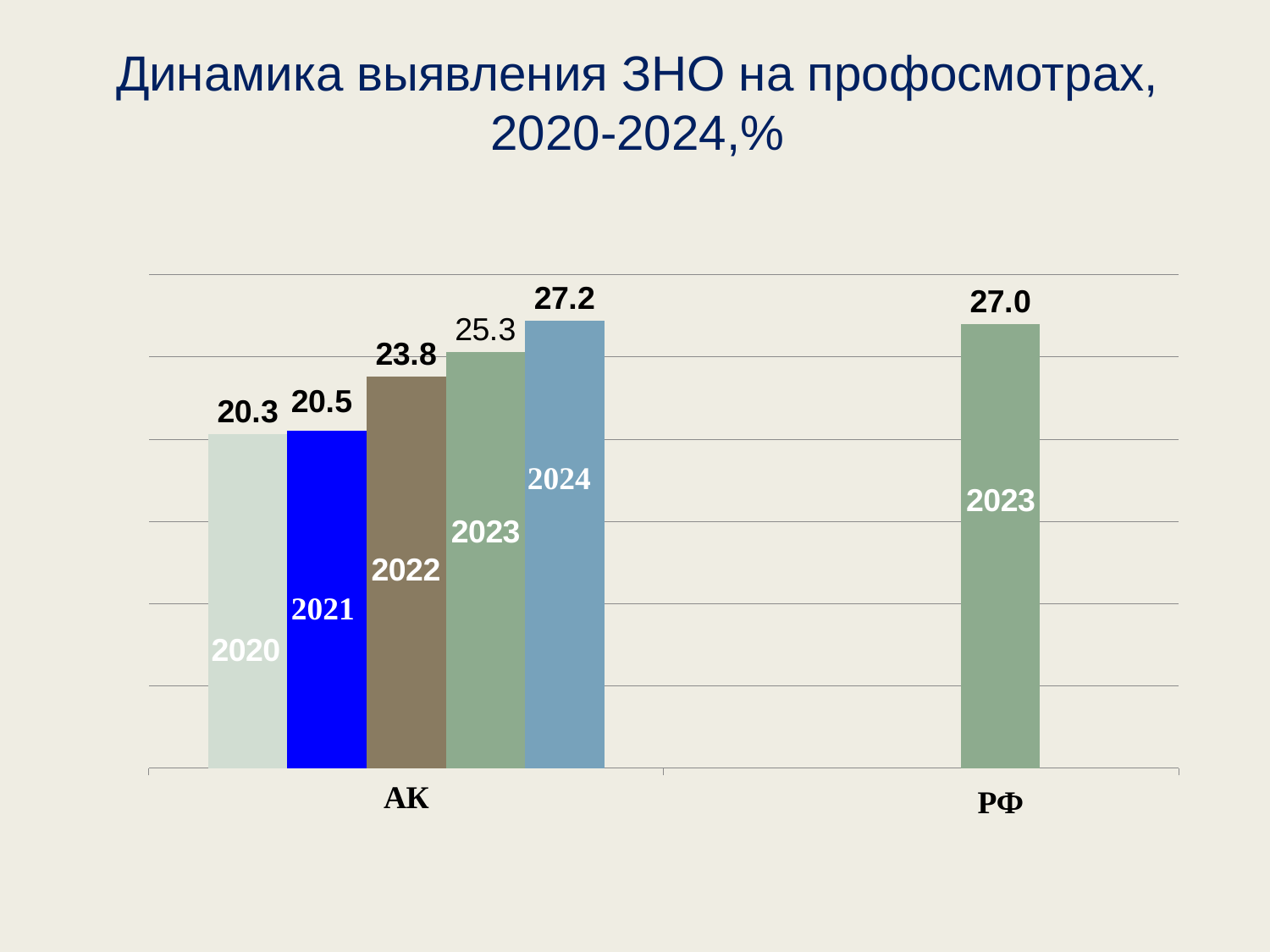
What is the value for 2020 in the АК group? 20.3 Which year has the highest value in the АК group? 2024 What kind of chart is shown on the slide? bar chart Which year has the lowest value in the АК group? 2020 Do the АК values rise or fall from 2020 to 2024? rise What is the difference between the АК values for 2024 and 2020? 6.9 Which is larger: the АК value for 2023 or the РФ value for 2023? РФ How many bars are shown for the АК group? 5 What is the difference between the РФ 2023 value and the АК 2023 value? 1.7 What is the value for 2024 in the АК group? 27.2 What is the value for 2022 in the АК group? 23.8 What is the value shown for РФ (2023)? 27.0